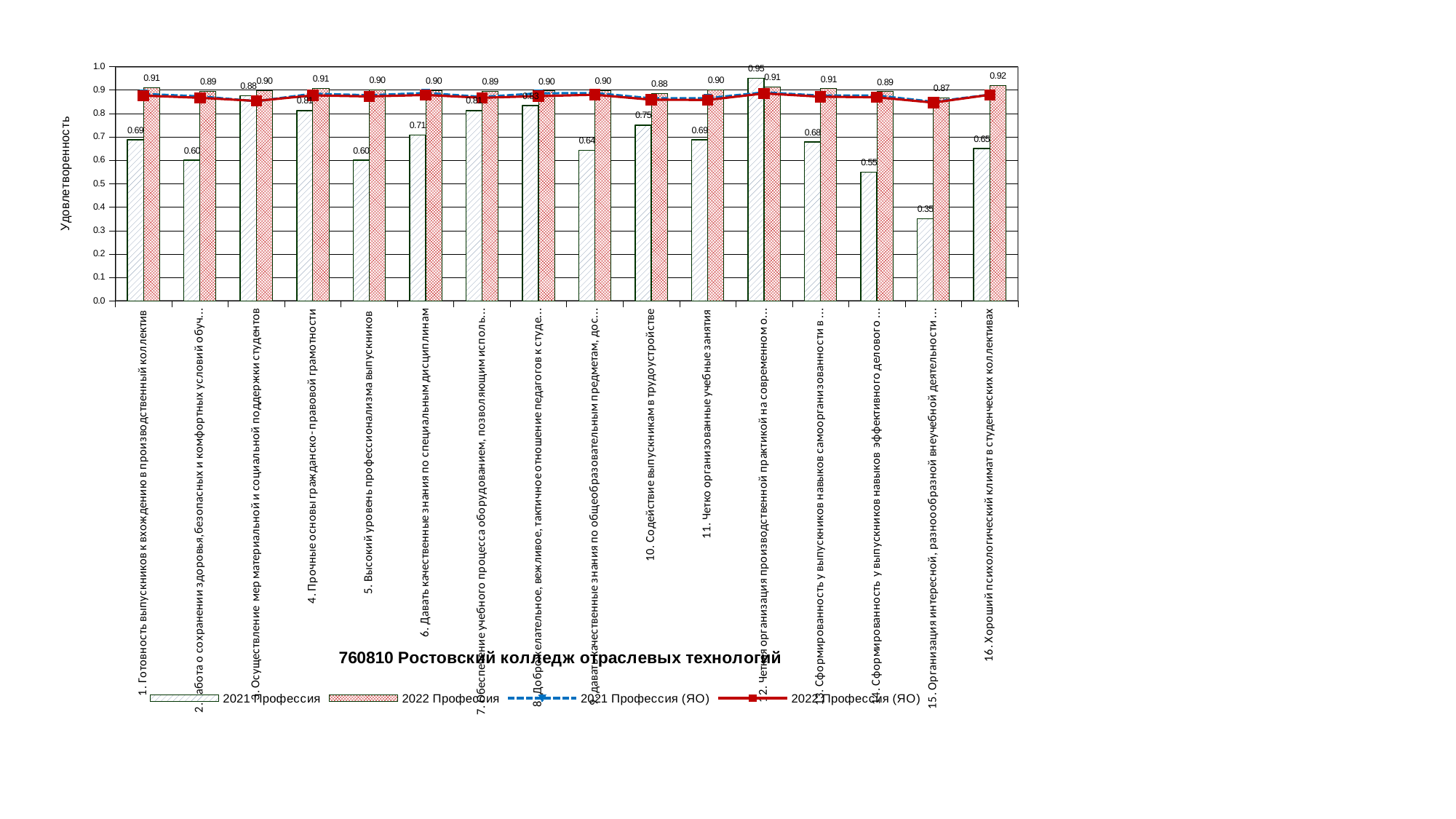
Which numbered category has the highest 2022 Профессия bar? 16 What is the value of the 2022 Профессия bar for category 16 (Хороший психологический климат в студенческих коллективах)? 0.92 For category 1 (Готовность выпускников к вхождению в производственный коллектив), which is larger: the 2021 Профессия bar or the 2022 Профессия bar? 2022 Профессия How many categories are shown on the x axis? 16 Is the 2021 Профессия value for category 15 greater or less than 0.4? less Which numbered category has the lowest 2021 Профессия bar? 15 What is the value of the 2022 Профессия bar for category 10 (Содействие выпускникам в трудоустройстве)? 0.88 What is the difference between the 2022 Профессия and 2021 Профессия values for category 16? 0.27 What is the value of the 2021 Профессия bar for category 5 (Высокий уровень профессионализма выпускников)? 0.60 What is the value of the 2021 Профессия bar for category 3 (Осуществление мер материальной и социальной поддержки студентов)? 0.88 Which numbered category has the highest 2021 Профессия bar? 12 How many series does the legend list? 4